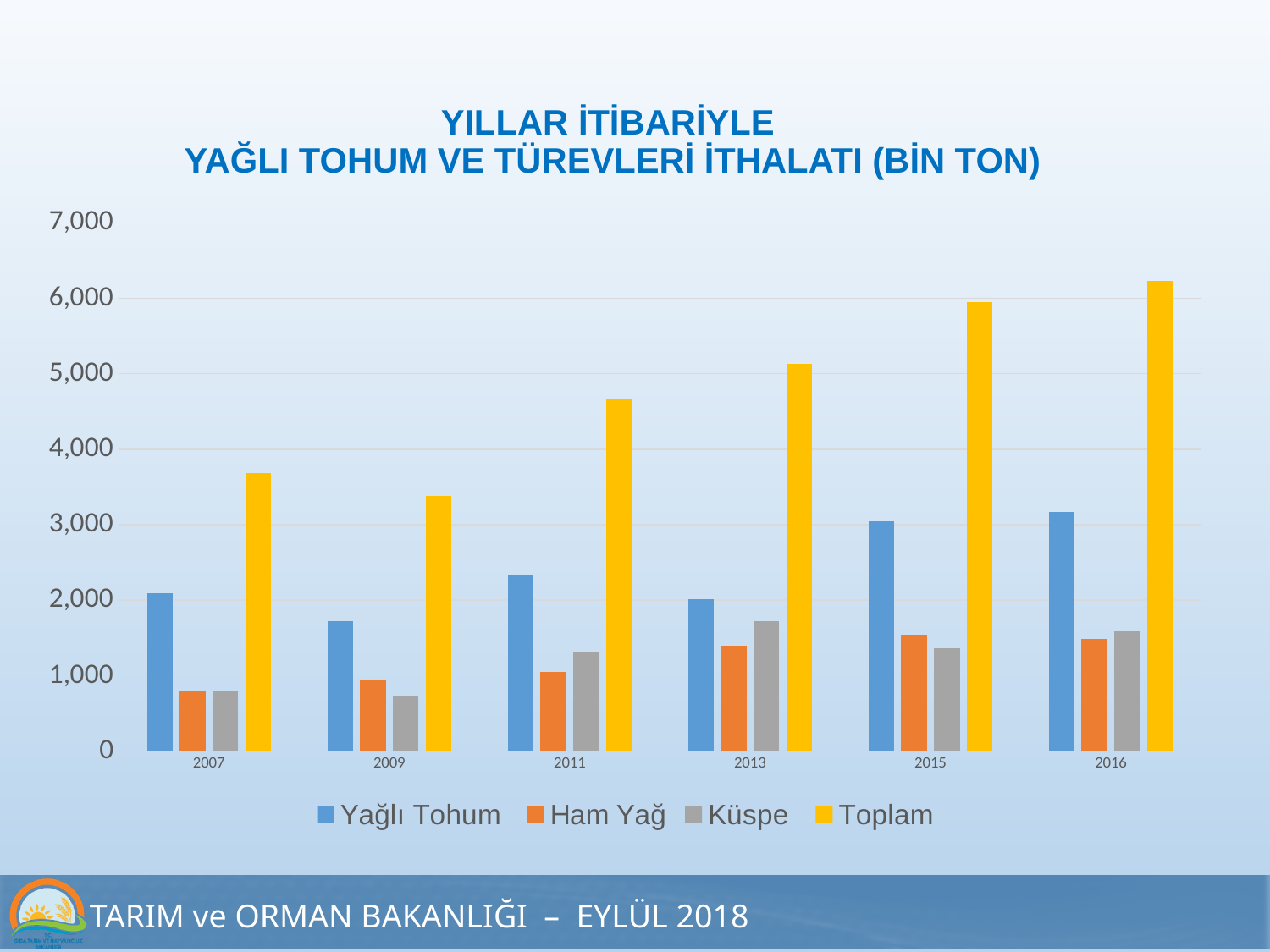
What kind of chart is shown on the slide? Bar chart Is the Ham Yağ value for 2007 greater or less than 1,000? less Which colour represents Toplam in the legend? Yellow How many years are shown on the x axis? 6 In which year is the Yağlı Tohum value lowest? 2009 In which year is the Toplam value highest? 2016 From 2009 to 2016, does the Toplam value rise or fall? rises In which year is the Toplam value lowest? 2009 In 2013, which is larger: Küspe or Ham Yağ? Küspe Is the Toplam value for 2007 greater or less than 4,000? less Is the Toplam value for 2016 greater or less than 6,000? greater How many series does the legend list? 4